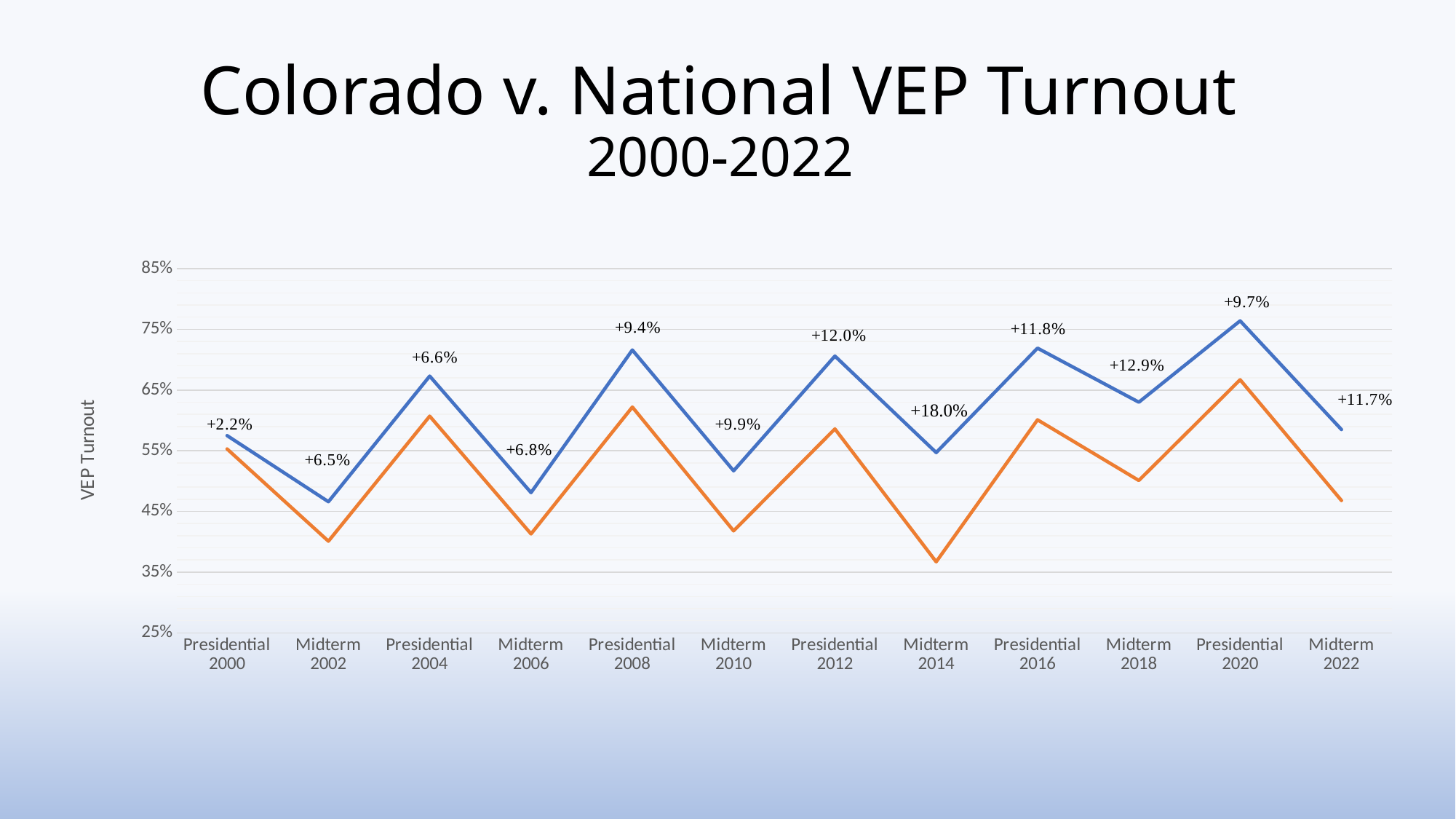
How many election points are plotted along the x axis? 12 Is the value of the orange line at Midterm 2014 greater or less than 45%? less At which election is the smallest printed difference label shown? Presidential 2000 What difference label is printed at the Midterm 2018 point? +12.9% What is the title of the chart on the slide? Colorado v. National VEP Turnout 2000-2022 Which line is higher at Presidential 2012, the blue line or the orange line? blue line How many lines are plotted on the chart? 2 What difference label is printed at the Presidential 2008 point? +9.4% Is the value of the blue line at Presidential 2008 greater or less than 65%? greater What kind of chart is shown on the slide? line chart Is the value of the blue line at Midterm 2002 greater or less than 55%? less At which election is the largest printed difference label shown? Midterm 2014